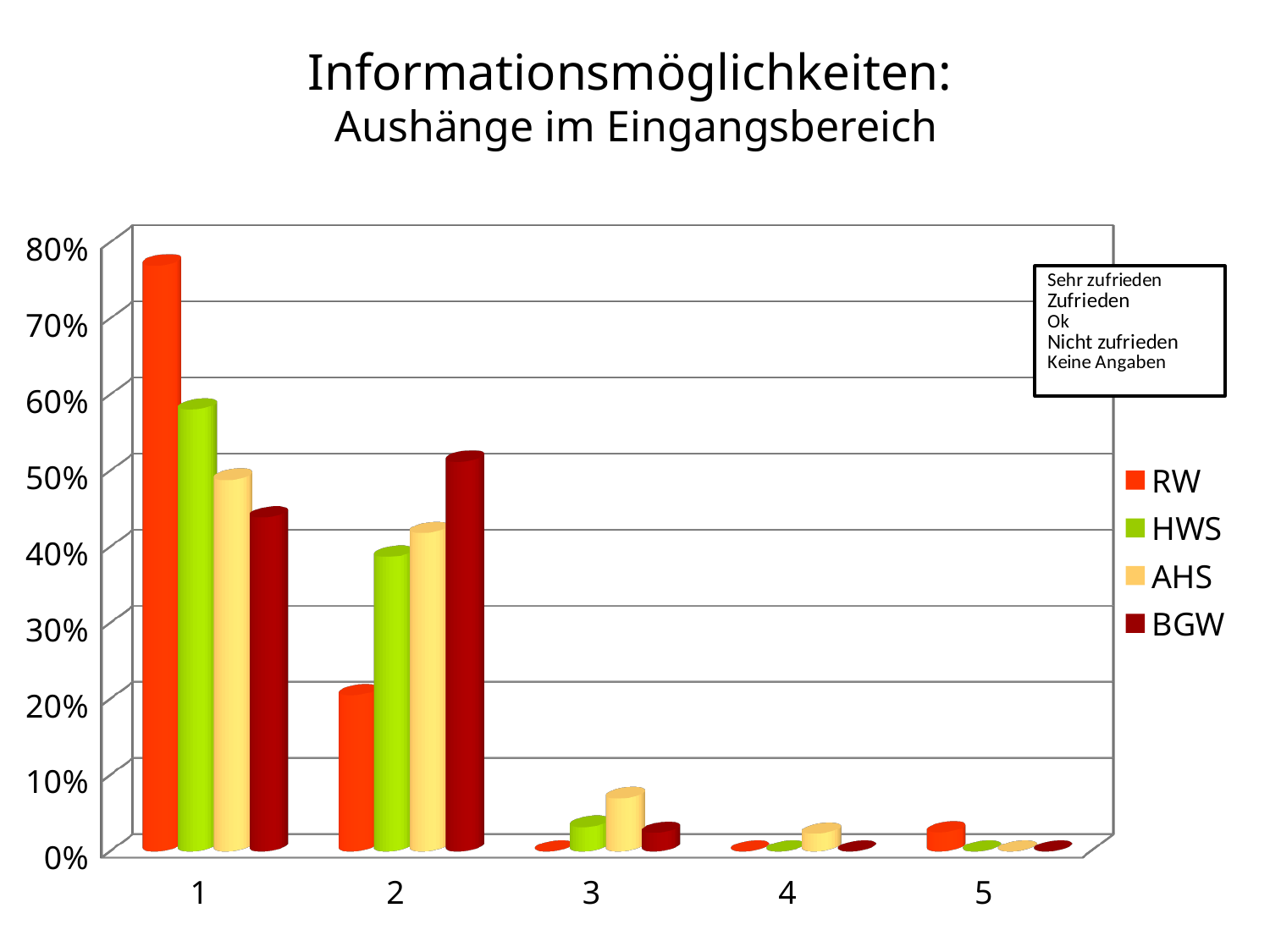
What kind of chart is shown on the slide? bar chart Do the values for RW rise or fall from category 1 to category 2? fall Which series has the highest value in category 1? RW Is the value for RW in category 2 greater or less than 30%? less In category 1, which is larger: the value for HWS or the value for BGW? HWS Which series has the highest value in category 2? BGW What is the title of the chart? Informationsmöglichkeiten: Aushänge im Eingangsbereich Which series has the lowest value in category 2? RW Is the value for RW in category 1 greater or less than 70%? greater How many categories are shown on the x axis? 5 How many series does the legend list? 4